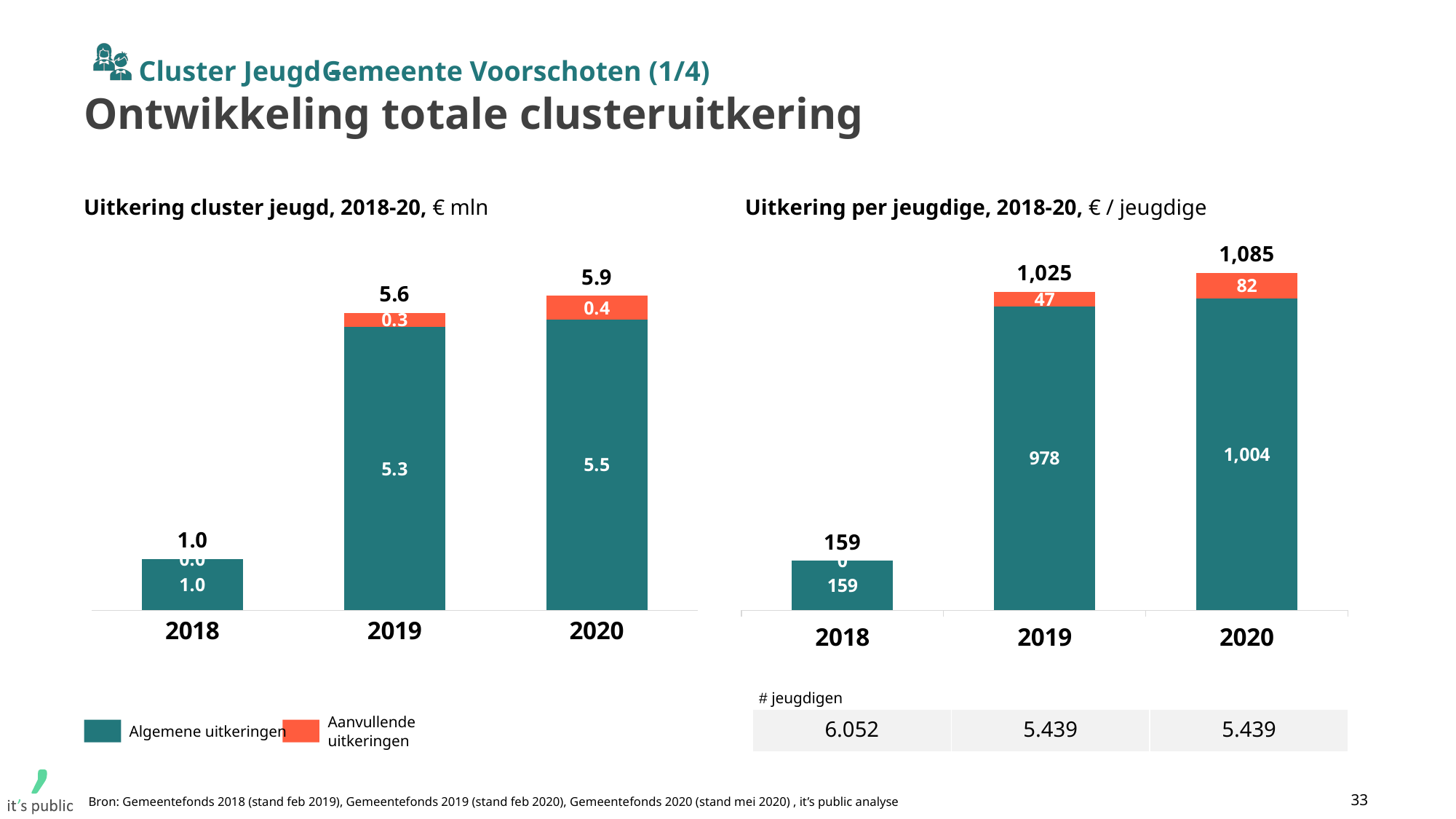
In the chart 'Uitkering cluster jeugd, 2018-20', what is the value of Algemene uitkeringen in 2020? 5.5 In the chart 'Uitkering per jeugdige, 2018-20', what is the difference between the totals for 2019 and 2018? 866 In the chart 'Uitkering per jeugdige, 2018-20', what is the total for 2020? 1,085 In the chart 'Uitkering cluster jeugd, 2018-20', what is the value of Aanvullende uitkeringen in 2019? 0.3 In the chart 'Uitkering per jeugdige, 2018-20', what is the value of Aanvullende uitkeringen in 2020? 82 In the chart 'Uitkering per jeugdige, 2018-20', what is the value of Algemene uitkeringen in 2019? 978 In the chart 'Uitkering cluster jeugd, 2018-20', what is the total value for 2019? 5.6 In the chart 'Uitkering cluster jeugd, 2018-20', which year has the lowest total? 2018 What kind of chart is 'Uitkering cluster jeugd, 2018-20'? Stacked bar chart In the chart 'Uitkering per jeugdige, 2018-20', which year has the highest total? 2020 How many series does the legend list for the charts on this slide? 2 In the chart 'Uitkering cluster jeugd, 2018-20', what is the difference between the totals for 2020 and 2019? 0.3